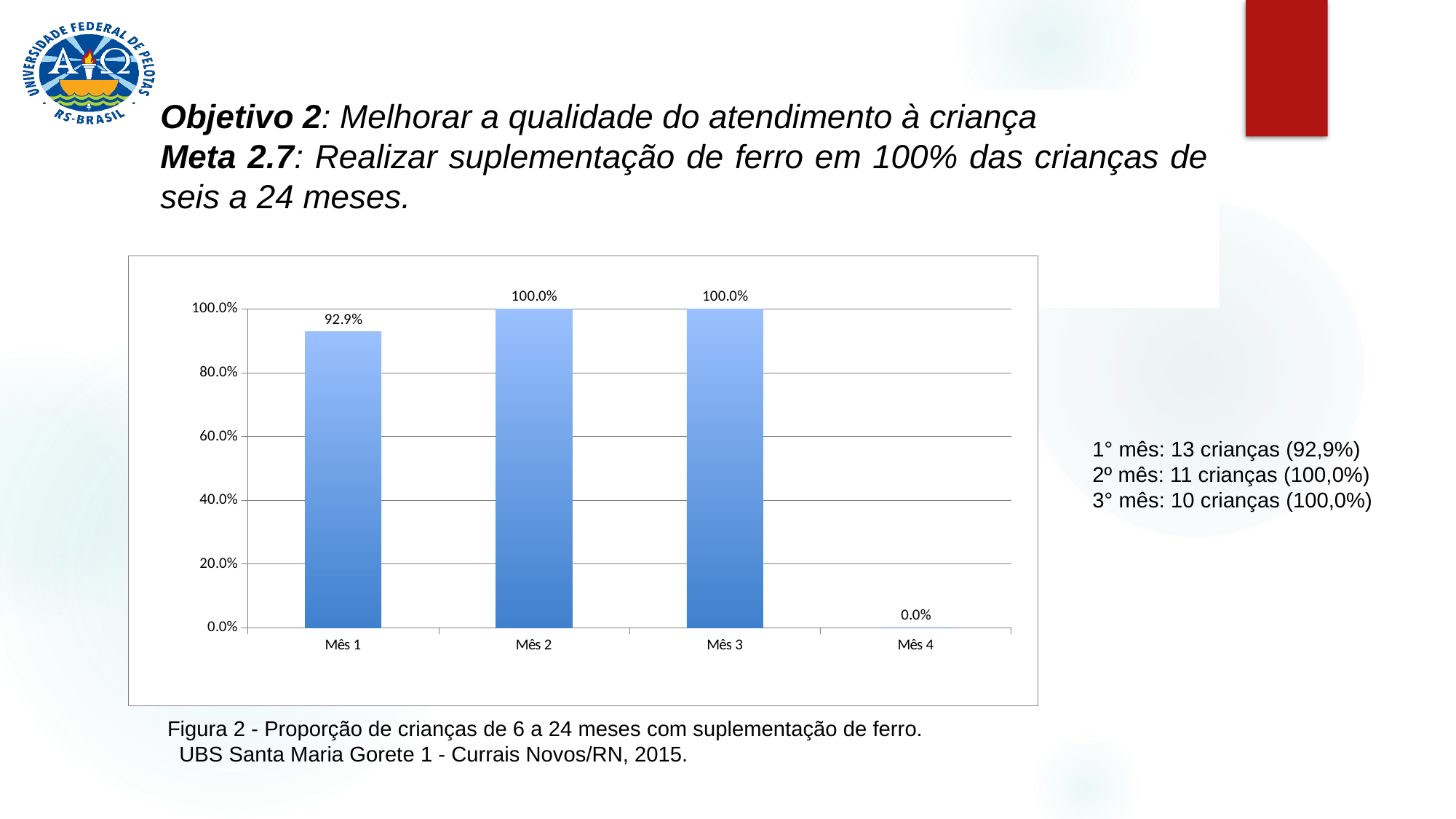
Do the values rise or fall from Mês 1 to Mês 2? rise Which category has the lowest value? Mês 4 What is the difference between the values for Mês 2 and Mês 1? 7.1% How many categories are shown on the x axis? 4 What is the value for Mês 4? 0.0% What kind of chart is shown on the slide? bar chart What is the figure caption below the chart? Figura 2 - Proporção de crianças de 6 a 24 meses com suplementação de ferro. UBS Santa Maria Gorete 1 - Currais Novos/RN, 2015. Is the value for Mês 1 greater or less than 80.0%? greater Which is larger, the value for Mês 1 or the value for Mês 3? Mês 3 What is the highest value shown on the y axis? 100.0% What is the value for Mês 1? 92.9% What is the value for Mês 2? 100.0%